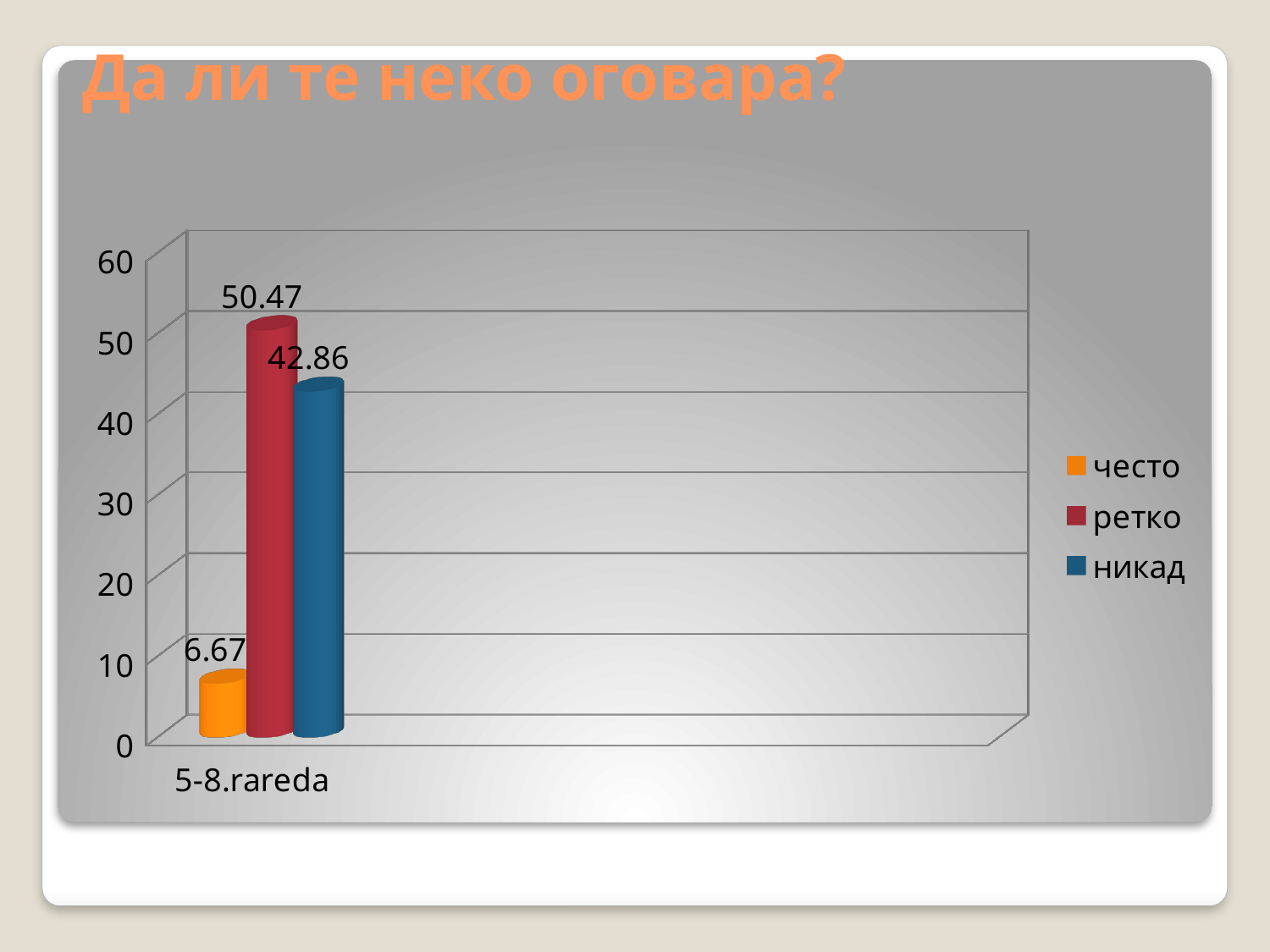
Which is larger, the value for "ретко" or the value for "никад"? ретко What kind of chart is shown on the slide? bar chart What is the value for the series "често" for the category "5-8.rareda"? 6.67 Which series has the lowest value? често How many series does the legend list? 3 Which series has the highest value? ретко What is the value for the series "никад" for the category "5-8.rareda"? 42.86 What is the difference between the values for "ретко" and "никад"? 7.61 What is the title of the slide? Да ли те неко оговара? Is the value for "никад" greater or less than 40? greater What is the difference between the values for "никад" and "често"? 36.19 What is the value for the series "ретко" for the category "5-8.rareda"? 50.47